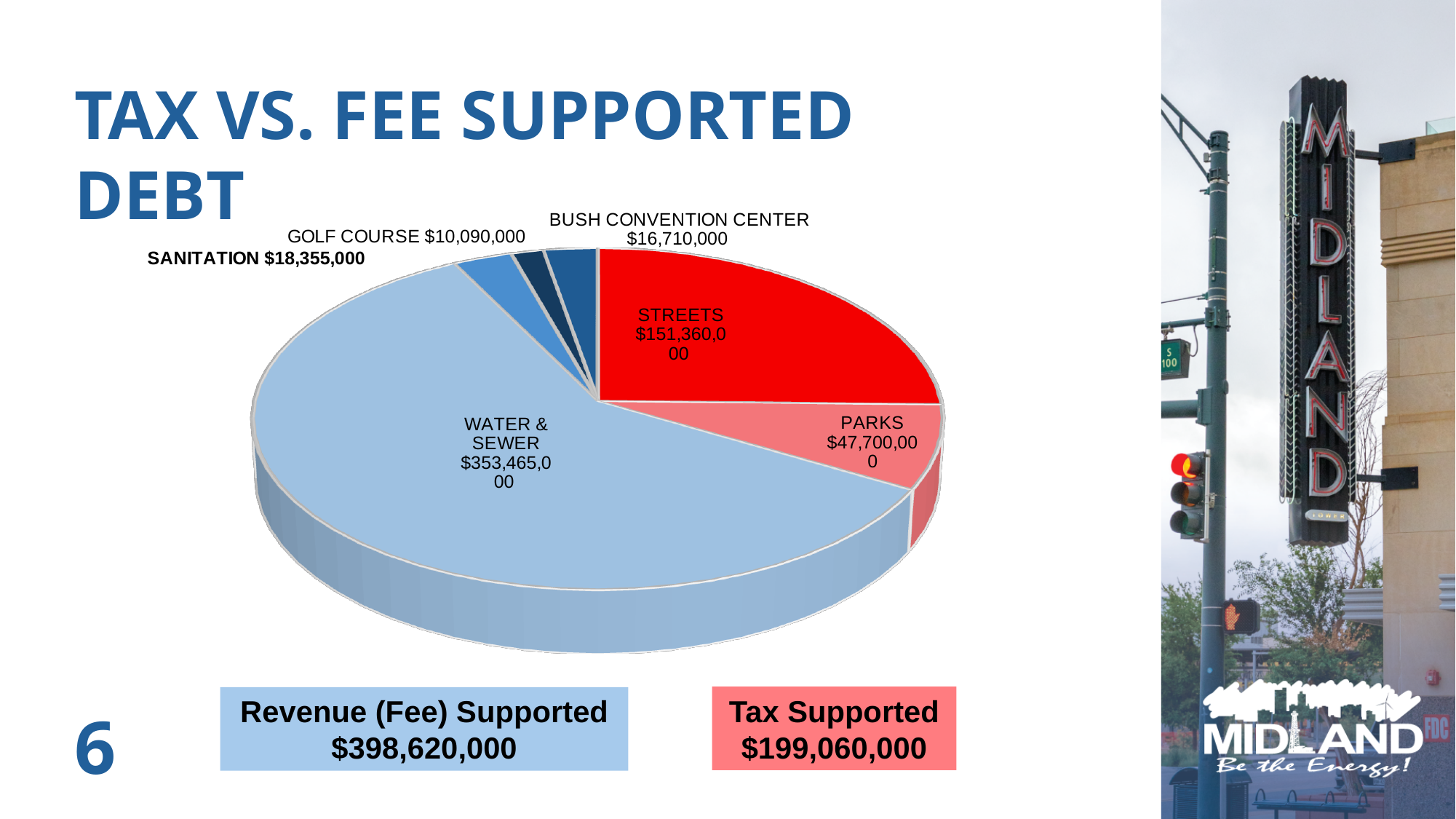
What is the value for Water & Sewer? $353,465,000 What is the difference between the Streets value and the Parks value? $103,660,000 Which category has the smallest slice of the pie? Golf Course What is the difference between the Sanitation value and the Golf Course value? $8,265,000 What is the value for Parks? $47,700,000 What kind of chart is shown on the slide? Pie chart How many slices does the pie chart have? 6 What total is shown for Tax Supported debt below the chart? $199,060,000 What is the value for Streets? $151,360,000 Which is larger, Sanitation or Bush Convention Center? Sanitation What is the value for Golf Course? $10,090,000 Which category has the largest slice of the pie? Water & Sewer